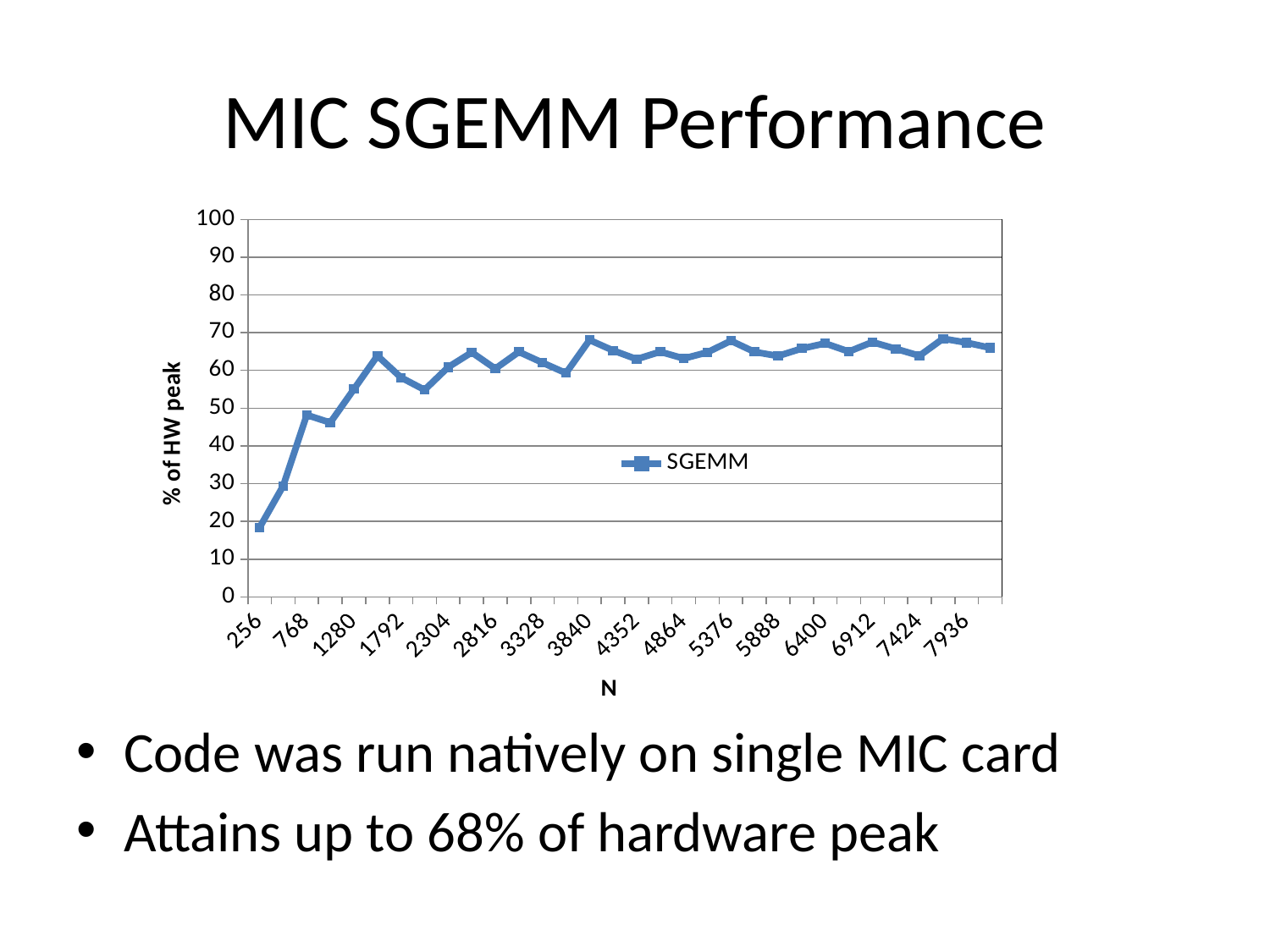
What kind of chart is shown on the slide? line chart How many labelled tick values are shown on the x axis? 16 Which has the higher value, N = 256 or N = 7936? 7936 Is the value for N = 256 greater or less than 30? less Is the value for N = 768 greater or less than 40? greater Is the value for N = 3840 greater or less than 60? greater At which N value is the SGEMM performance lowest? 256 Overall, do the values rise or fall as N increases along the x axis? rise What is the name of the series shown in the legend? SGEMM How many series does the legend list? 1 What is the label of the y axis? % of HW peak